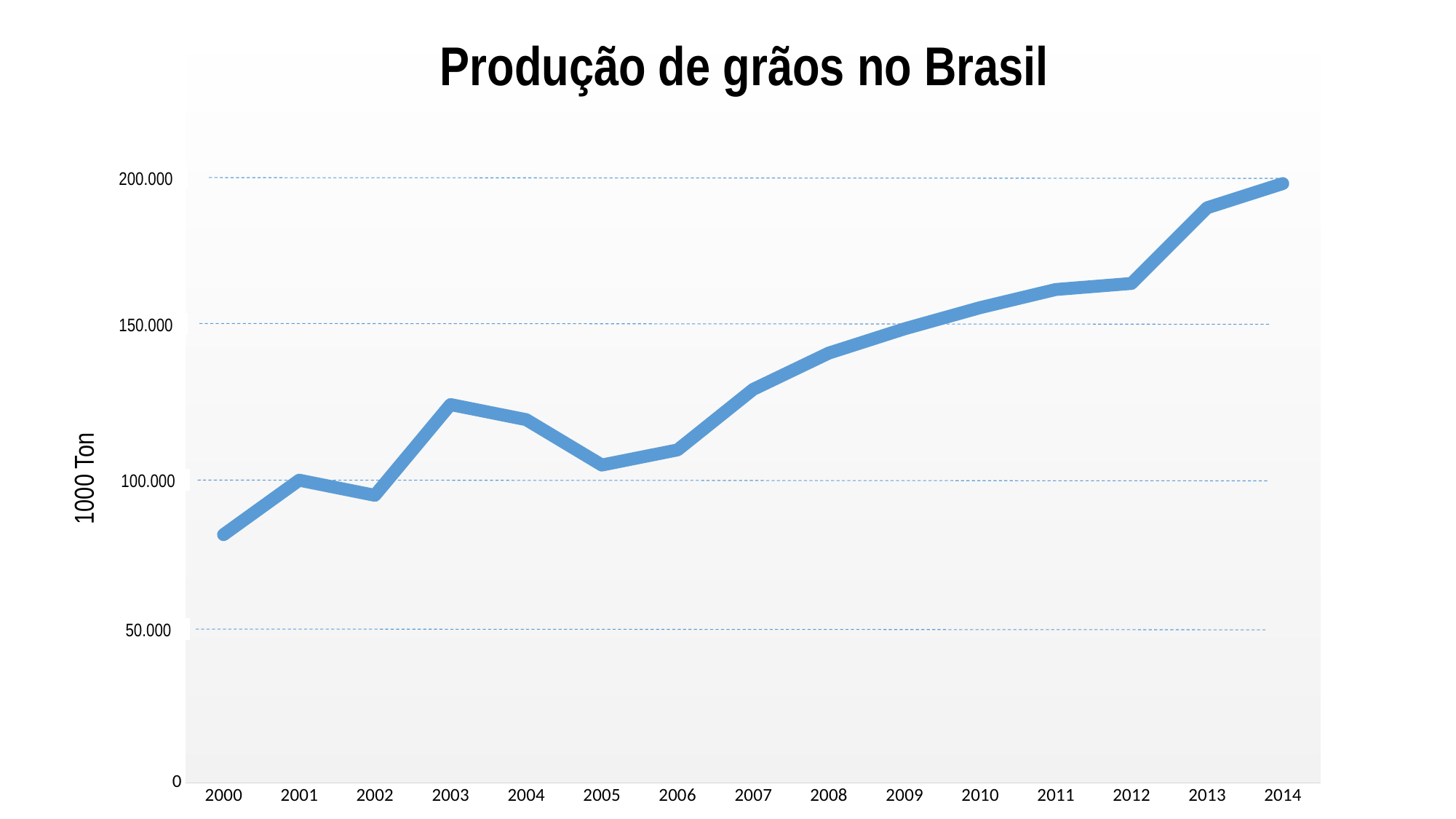
What is the label on the vertical axis? 1000 Ton Which year has the lowest value? 2000 Is the value for 2007 greater or less than 150.000? less Which year has the larger value, 2003 or 2005? 2003 What is the title of the chart? Produção de grãos no Brasil What kind of chart is shown on the slide? line chart Is the value for 2013 greater or less than 150.000? greater Is the value for 2000 greater or less than 100.000? less Overall, do the values rise or fall from 2000 to 2014? rise How many years are plotted along the x axis? 15 Which year has the highest value? 2014